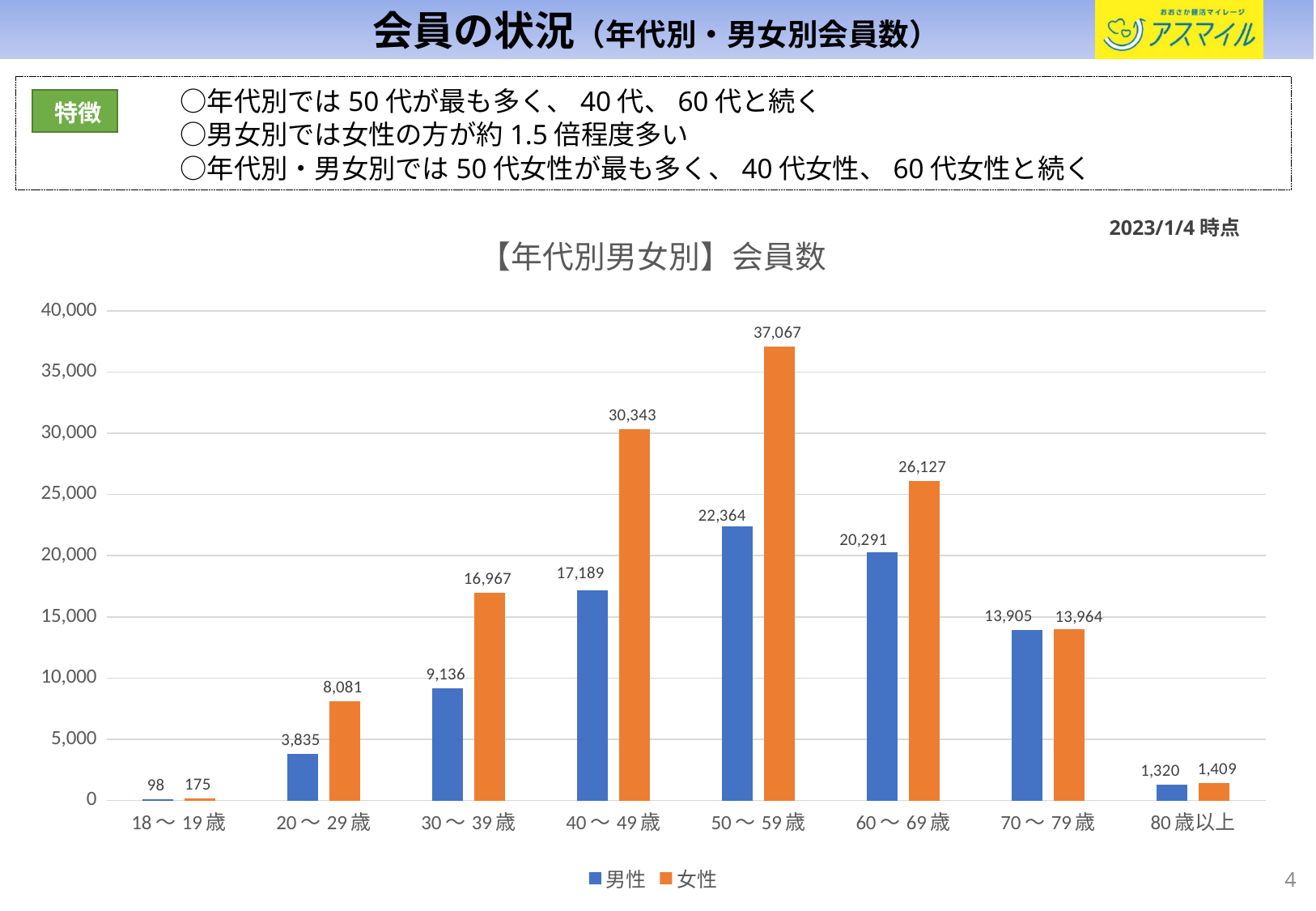
What type of chart is shown on the slide? bar chart Which age category has the highest value for 女性? 50〜59歳 How many age categories are shown on the x axis? 8 What is the value for 女性 in the 40〜49歳 category? 30,343 What is the value for 男性 in the 80歳以上 category? 1,320 What is the value for 女性 in the 18〜19歳 category? 175 What is the difference between the 女性 and 男性 values in the 50〜59歳 category? 14,703 Which age category has the lowest value for 男性? 18〜19歳 What is the value for 男性 in the 50〜59歳 category? 22,364 How many series does the legend list? 2 Is the value for 女性 in the 30〜39歳 category greater or less than 15,000? greater Which is larger in the 60〜69歳 category, the 男性 value or the 女性 value? 女性